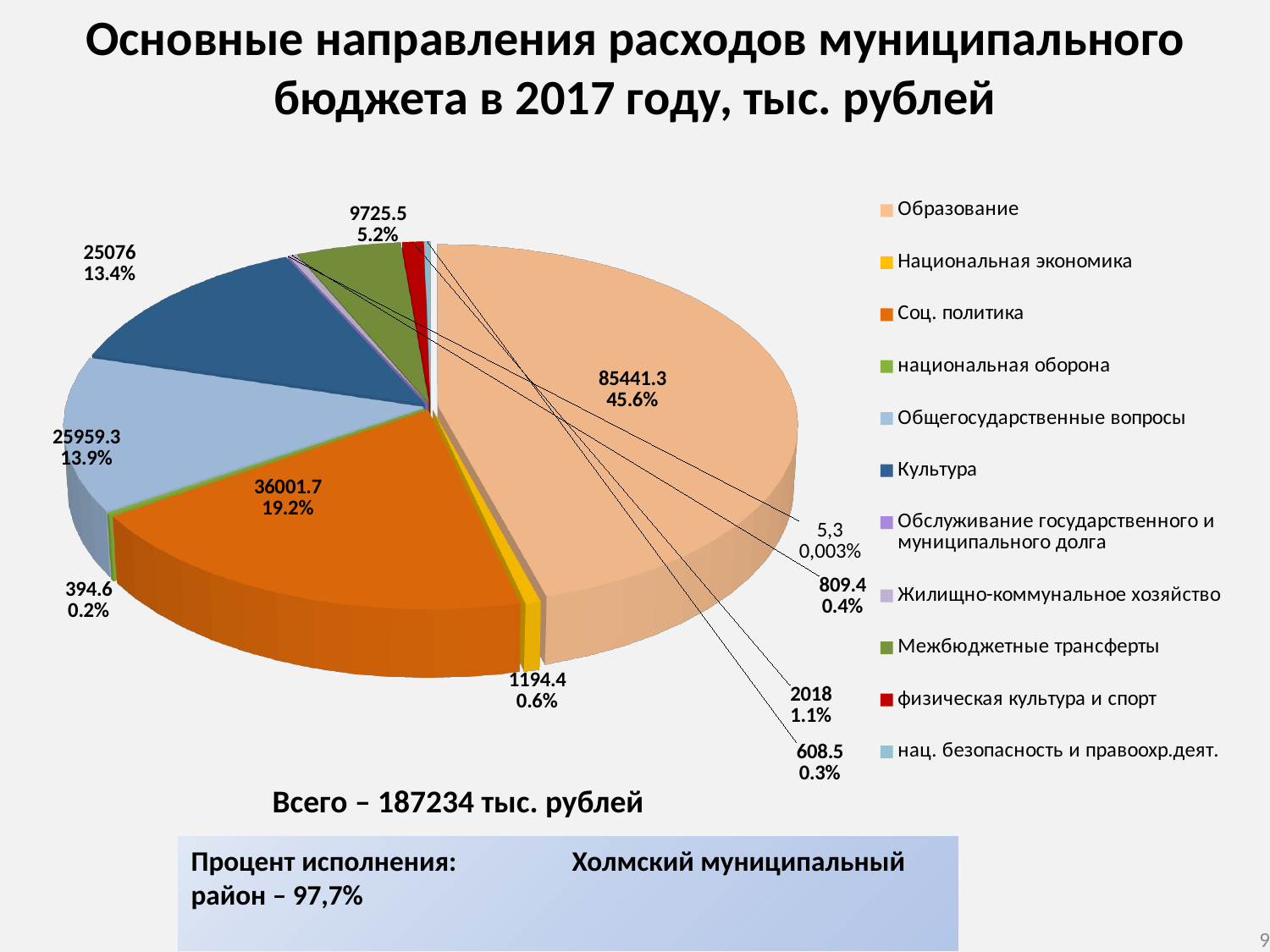
Which is larger, the value for Общегосударственные вопросы or the value for Культура? Общегосударственные вопросы What is the difference between the values for Соц. политика and Общегосударственные вопросы? 10042.4 What is the value for Образование? 85441.3 What share of the pie does Образование take? 45.6% What kind of chart is shown on the slide? pie chart What share of the pie does Культура take? 13.4% What is the total of all expenditures shown below the chart? 187234 тыс. рублей What colour is the slice for Соц. политика? orange Which category has the smallest slice of the pie? Обслуживание государственного и муниципального долга Which category has the largest slice of the pie? Образование How many categories does the legend of the pie chart list? 11 What is the value for Соц. политика? 36001.7